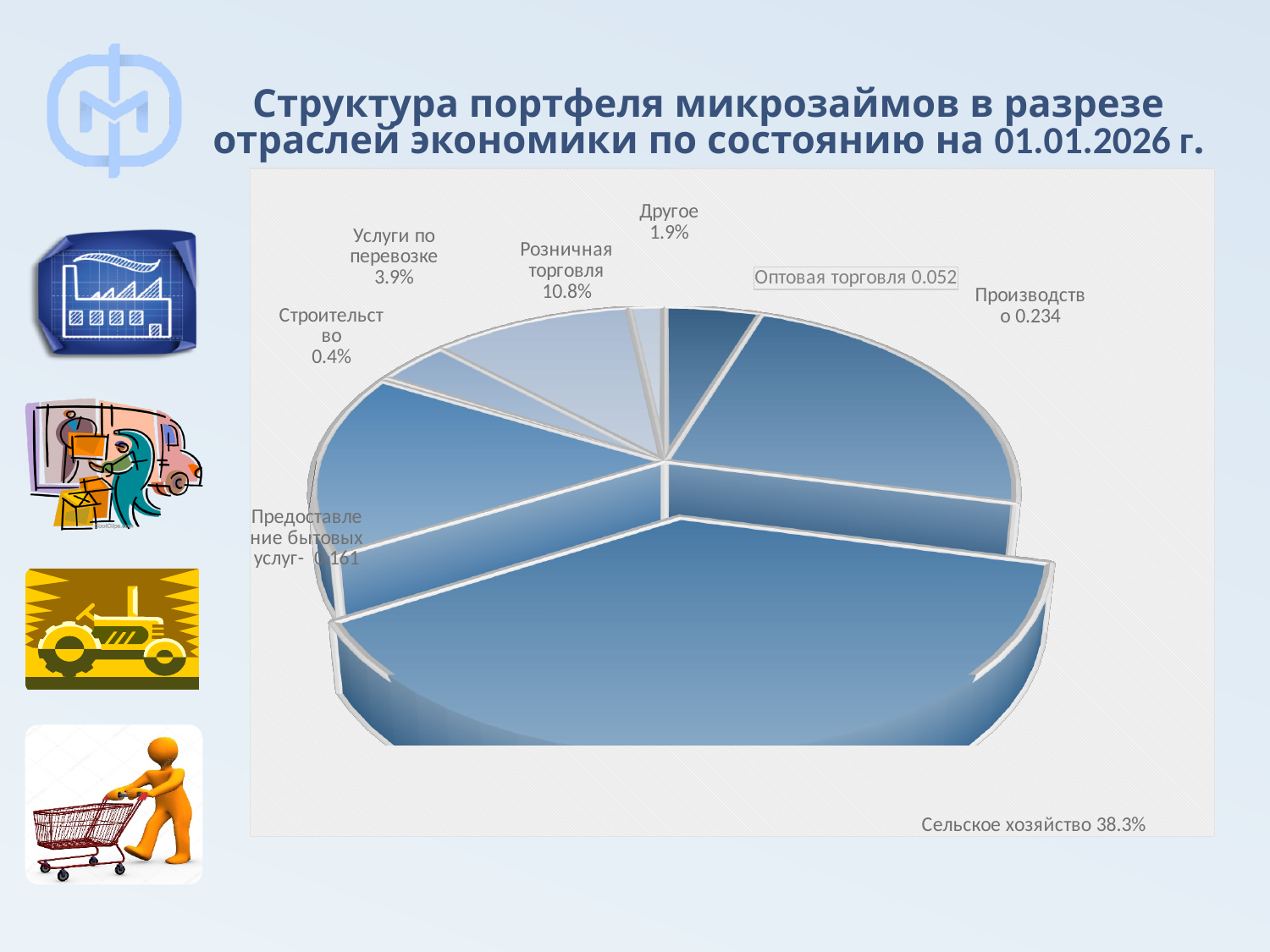
Which is larger, the share for Сельское хозяйство or for Розничная торговля? Сельское хозяйство What is the value shown for Услуги по перевозке? 3.9% What is the share for Сельское хозяйство? 38.3% What is the difference between the shares for Сельское хозяйство and Розничная торговля? 27.5% What type of chart is shown on the slide? Pie chart What is the value shown for Производство? 0.234 Which category has the smallest share of the pie? Строительство What is the value shown for Розничная торговля? 10.8% What is the value shown for Предоставление бытовых услуг? 0.161 How many categories are shown in the pie chart? 8 Which category has the largest share of the pie? Сельское хозяйство What is the value shown for Оптовая торговля? 0.052